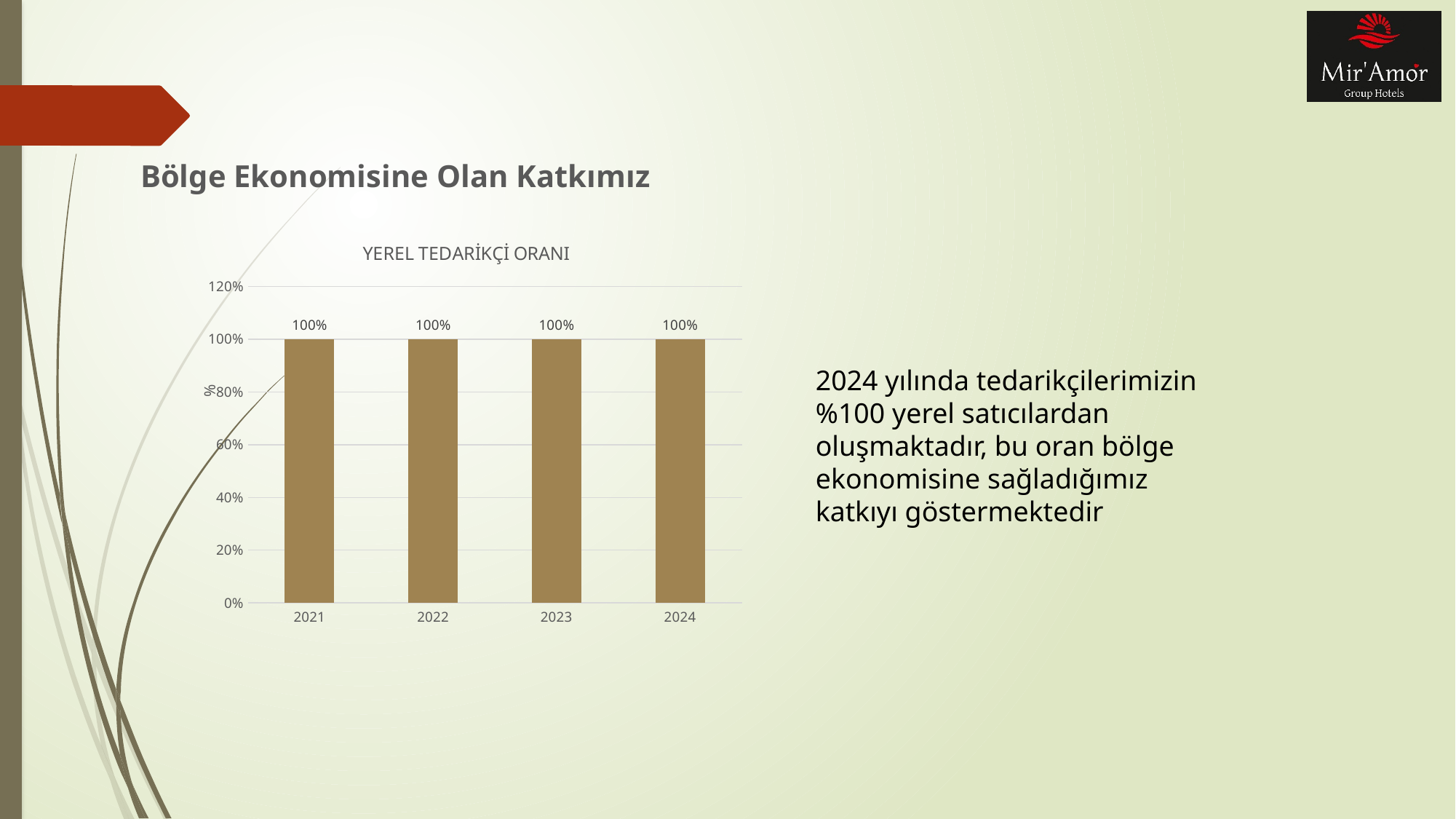
What kind of chart is shown on the slide? bar chart How many years are shown on the x axis of the chart? 4 What is the highest value shown on the y axis of the chart? 120% What is the title of the chart? YEREL TEDARİKÇİ ORANI Do the values rise, fall or stay the same from 2021 to 2024? stay the same Is the value for 2023 greater or less than 80%? greater What is the value for 2022 in the chart? 100% What is the difference between the values for 2023 and 2021? 0% What is the value for 2021 in the chart? 100% What is the value for 2024 in the chart? 100% Is the value for 2022 greater or less than 120%? less